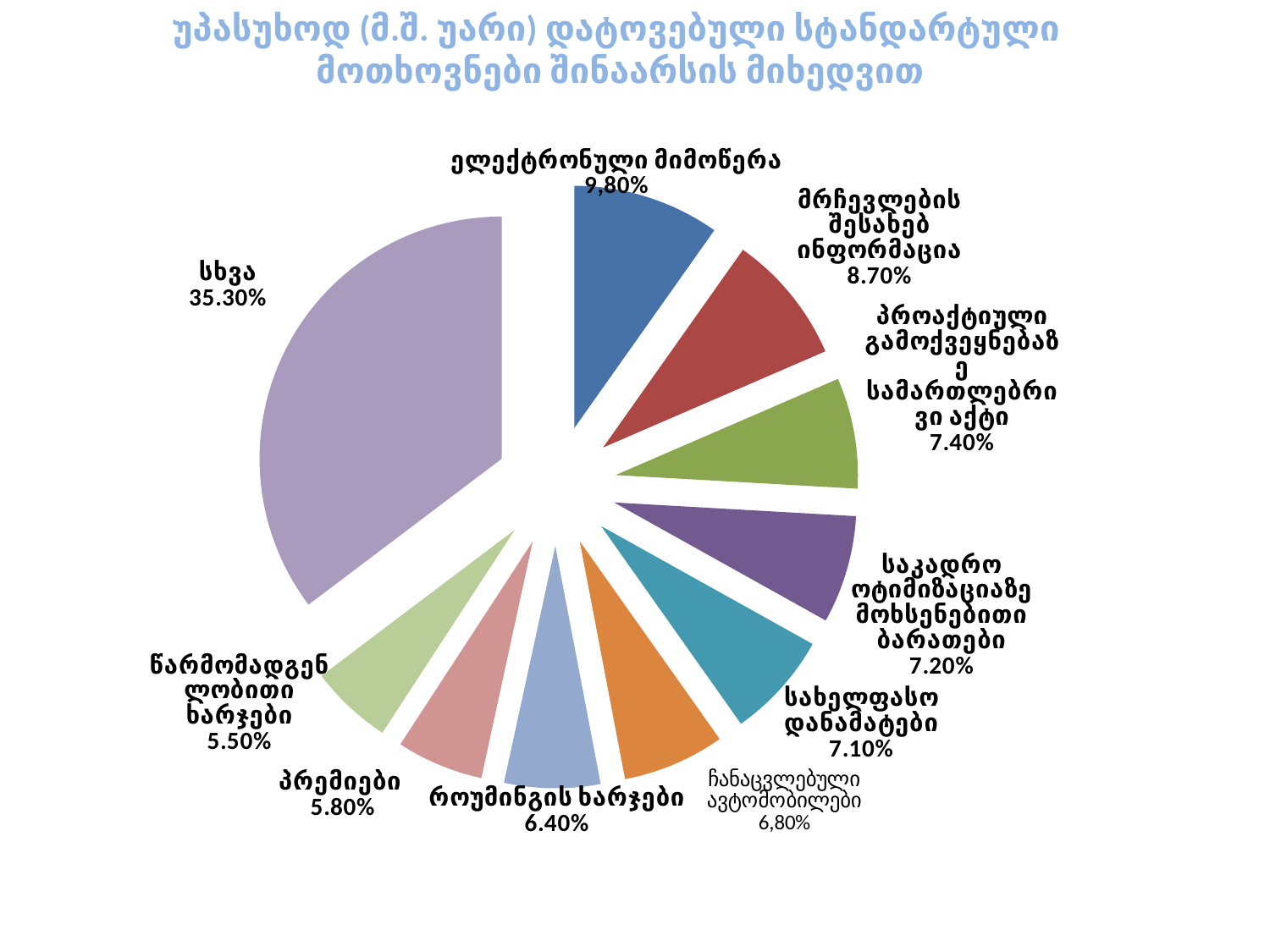
What is the value for the slice labelled "ჩანაცვლებული ავტომობილები"? 6,80% Which slice has the smallest share of the pie? წარმომადგენლობითი ხარჯები Which slice has the largest share of the pie? სხვა What is the value for the slice labelled "სხვა"? 35.30% What is the value for the slice labelled "ელექტრონული მიმოწერა"? 9,80% What is the value for the slice labelled "პრემიები"? 5.80% What type of chart is shown on the slide? pie chart Which is larger, the slice for "ელექტრონული მიმოწერა" or the slice for "მრჩევლების შესახებ ინფორმაცია"? ელექტრონული მიმოწერა What is the difference between the value for "სხვა" and the value for "ელექტრონული მიმოწერა"? 25.50% What is the value for the slice labelled "სახელფასო დანამატები"? 7.10% What is the value for the slice labelled "როუმინგის ხარჯები"? 6.40% How many slices does the pie chart have? 10